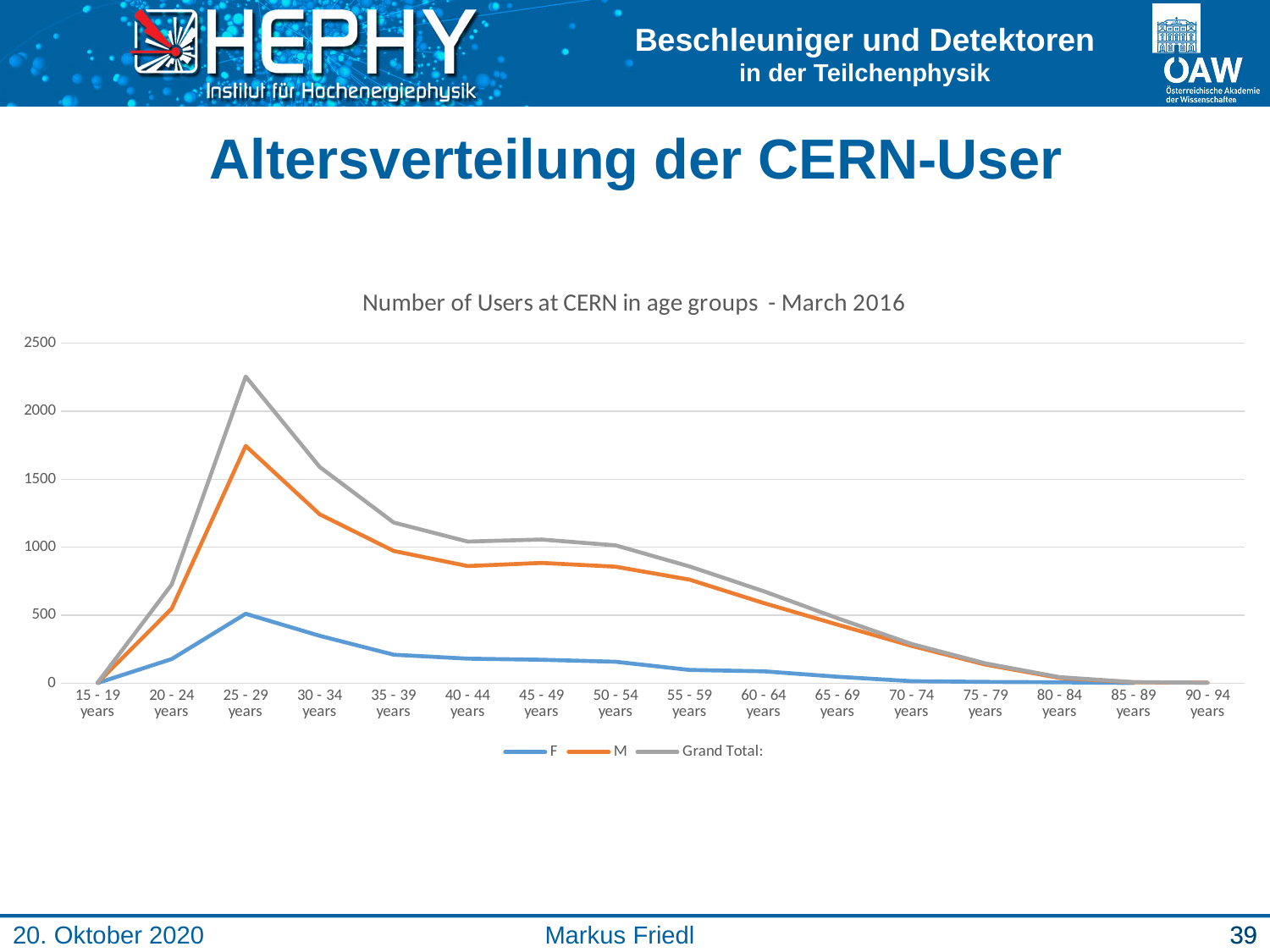
Is the Grand Total value for 25 - 29 years greater or less than 2000? greater Is the Grand Total value for 35 - 39 years greater or less than 1000? greater Do the Grand Total values rise or fall from 25 - 29 years to 90 - 94 years? fall Which is larger for 25 - 29 years, the M value or the F value? M How many series does the legend list? 3 Is the F value for 30 - 34 years greater or less than 500? less What kind of chart is shown on the slide? line chart Which age group has the highest value for the F series? 25 - 29 years What is the title of the chart? Number of Users at CERN in age groups - March 2016 Which age group has the highest Grand Total value? 25 - 29 years How many age groups are shown on the x axis? 16